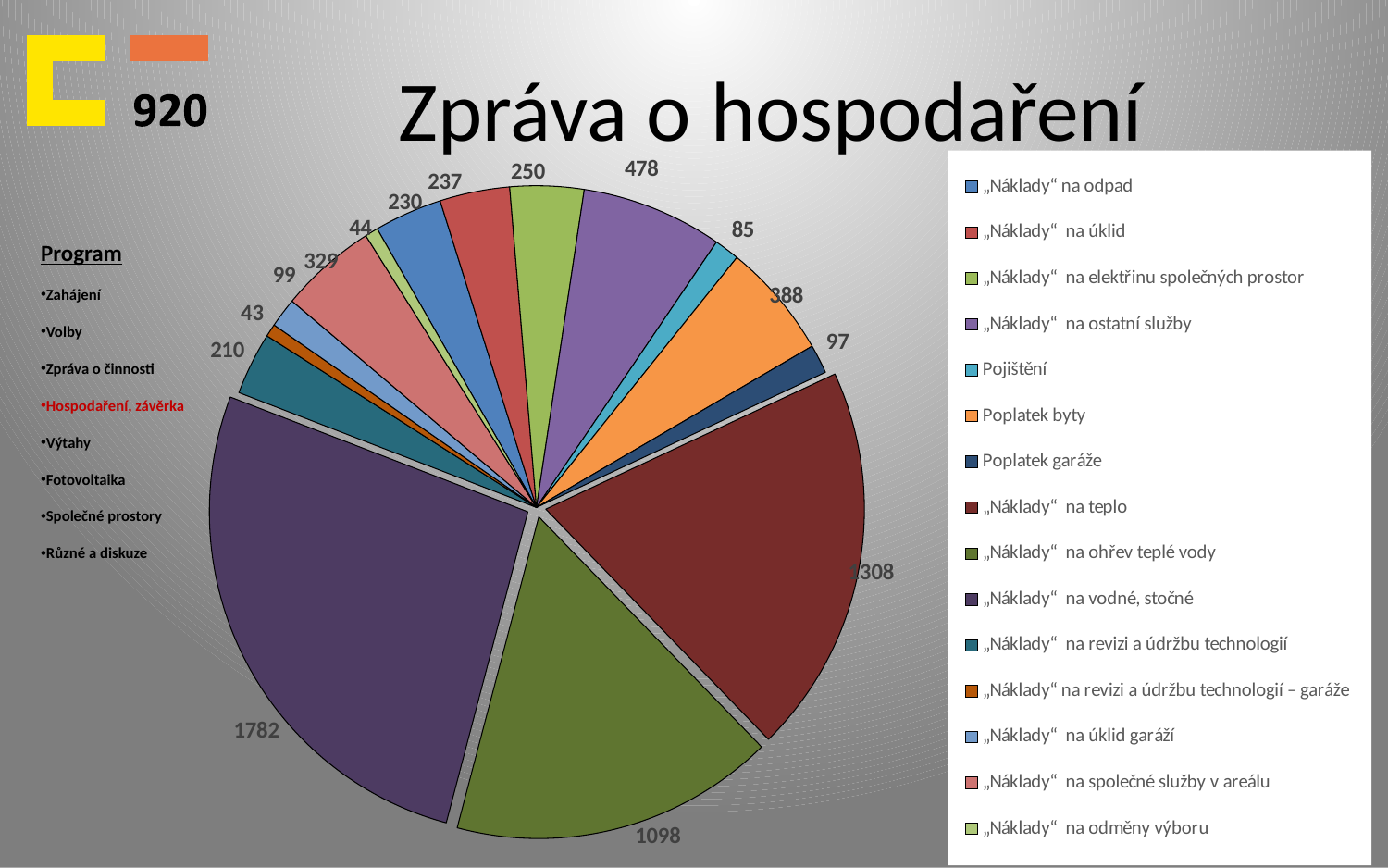
Which category has the largest slice in the pie chart? „Náklady" na vodné, stočné What is the value shown for Poplatek byty? 388 What is the difference between the values for „Náklady" na vodné, stočné and „Náklady" na teplo? 474 What is the difference between the values for „Náklady" na teplo and „Náklady" na ohřev teplé vody? 210 How many entries does the chart legend list? 15 Which is larger, the value for „Náklady" na teplo or for „Náklady" na ohřev teplé vody? „Náklady" na teplo What is the value shown for Pojištění? 85 What is the title of the chart on the slide? Zpráva o hospodaření How many slices does the pie chart have? 15 What kind of chart is shown on the slide? pie chart What is the value shown for „Náklady" na teplo? 1308 What is the value shown for „Náklady" na ohřev teplé vody? 1098